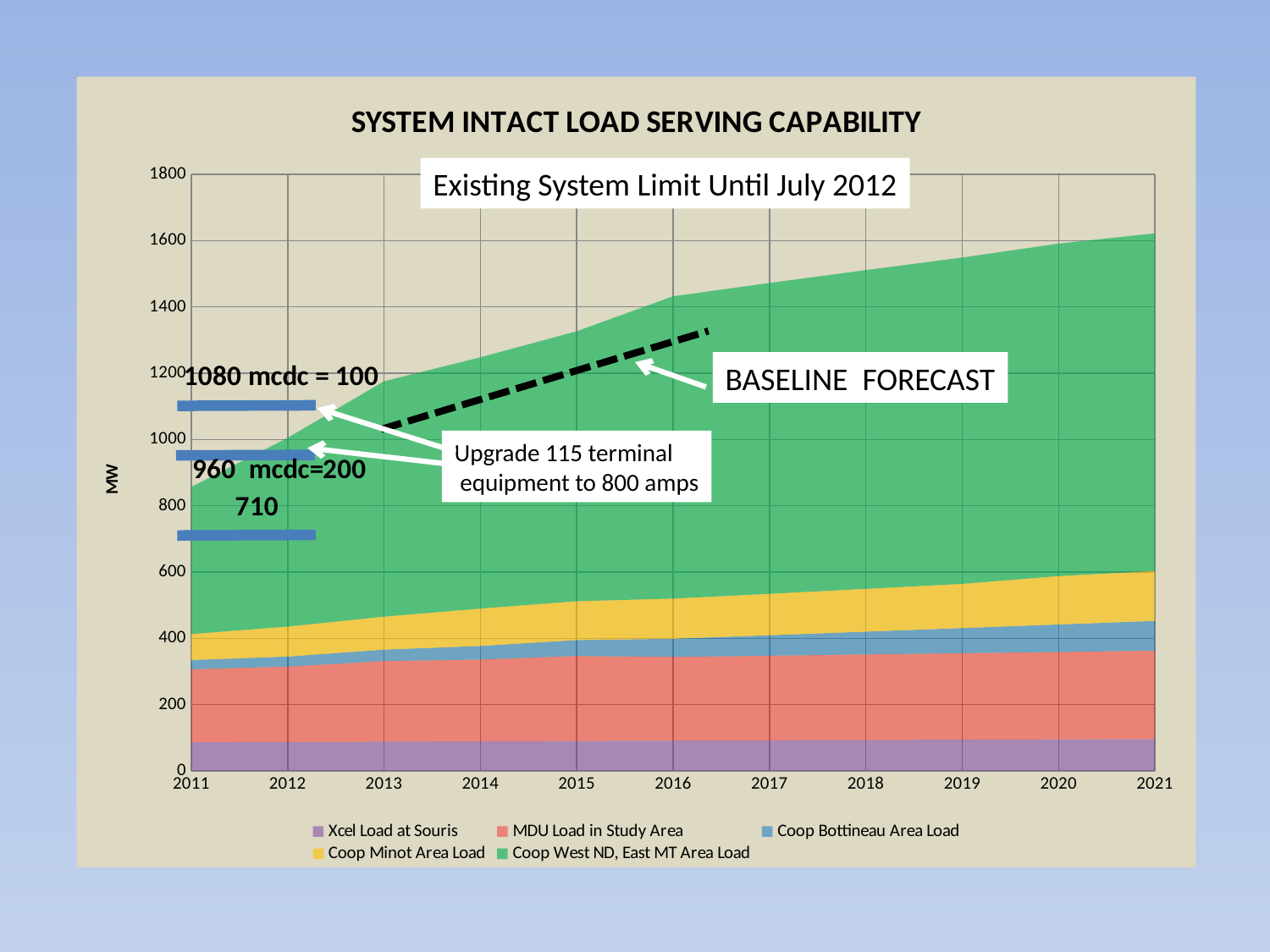
What value is written next to the lowest blue horizontal bar on the chart? 710 How many years are shown along the x axis? 11 Is the total stacked load in 2021 greater or less than 1400? greater What kind of chart is shown on the slide? Stacked area chart How many series does the legend list? 5 Does the total stacked load rise or fall from 2011 to 2021? Rise Which series occupies the largest band of the stacked area in 2021? Coop West ND, East MT Area Load Is the total stacked load in 2011 greater or less than 1000? less What is the label on the y axis? MW Which is larger in 2021, the MDU Load in Study Area band or the Coop Minot Area Load band? MDU Load in Study Area Is the value for Xcel Load at Souris in 2021 greater or less than 200? less What is the title of the chart? SYSTEM INTACT LOAD SERVING CAPABILITY